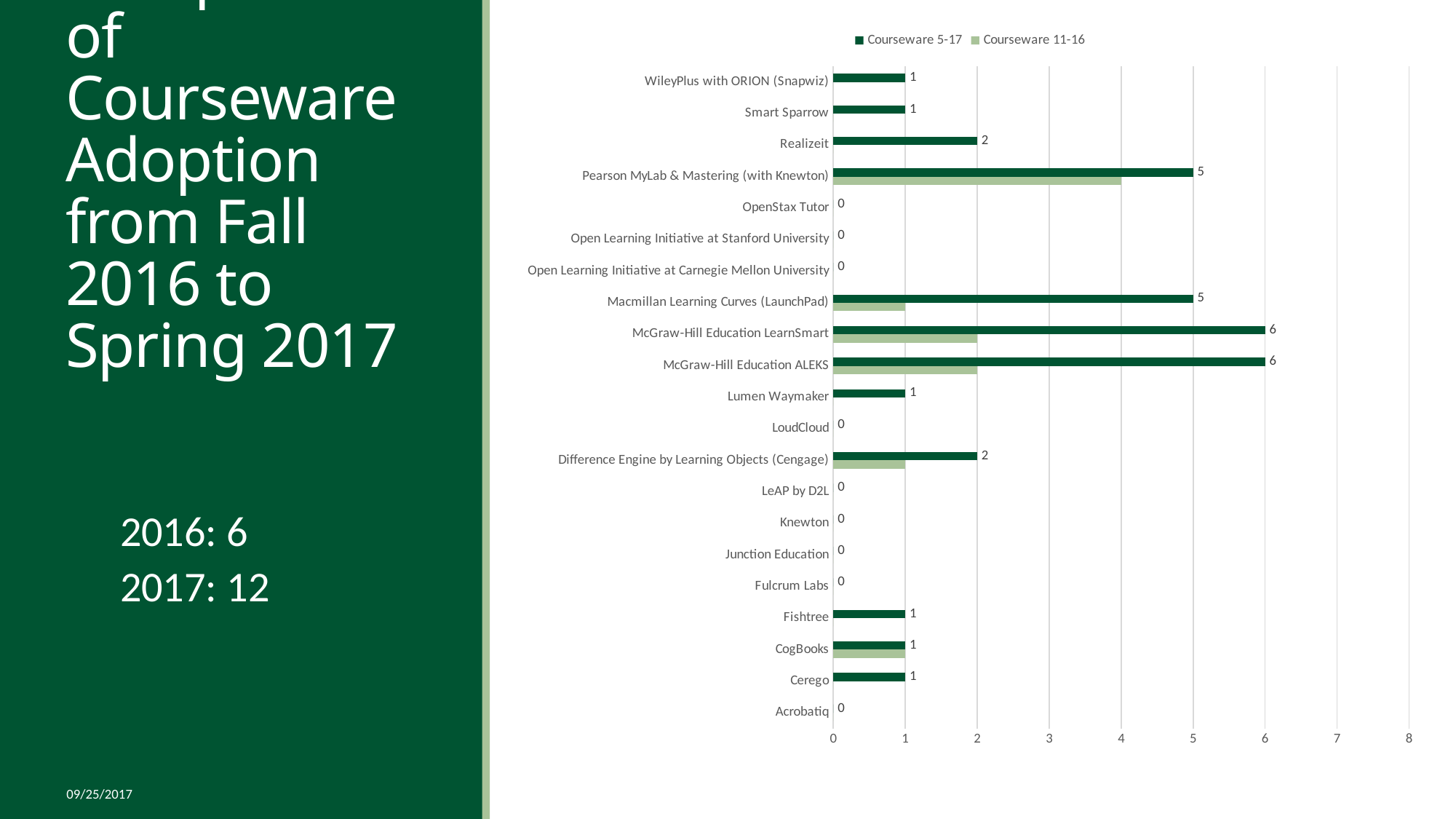
What is the Courseware 5-17 value for Difference Engine by Learning Objects (Cengage)? 2 What is the Courseware 11-16 value for Pearson MyLab & Mastering (with Knewton)? 4 What is the Courseware 5-17 value for Realizeit? 2 What is the Courseware 11-16 value for McGraw-Hill Education ALEKS? 2 Is the Courseware 5-17 value for McGraw-Hill Education ALEKS greater or less than 4? greater What is the Courseware 5-17 value for Pearson MyLab & Mastering (with Knewton)? 5 What kind of chart is shown on the slide? bar chart What is the difference between the Courseware 5-17 and Courseware 11-16 values for Macmillan Learning Curves (LaunchPad)? 4 Which series is shown in the darker green colour? Courseware 5-17 How many series does the legend list? 2 How many courseware categories are plotted on the chart? 21 Which is larger for McGraw-Hill Education LearnSmart: the Courseware 5-17 value or the Courseware 11-16 value? Courseware 5-17